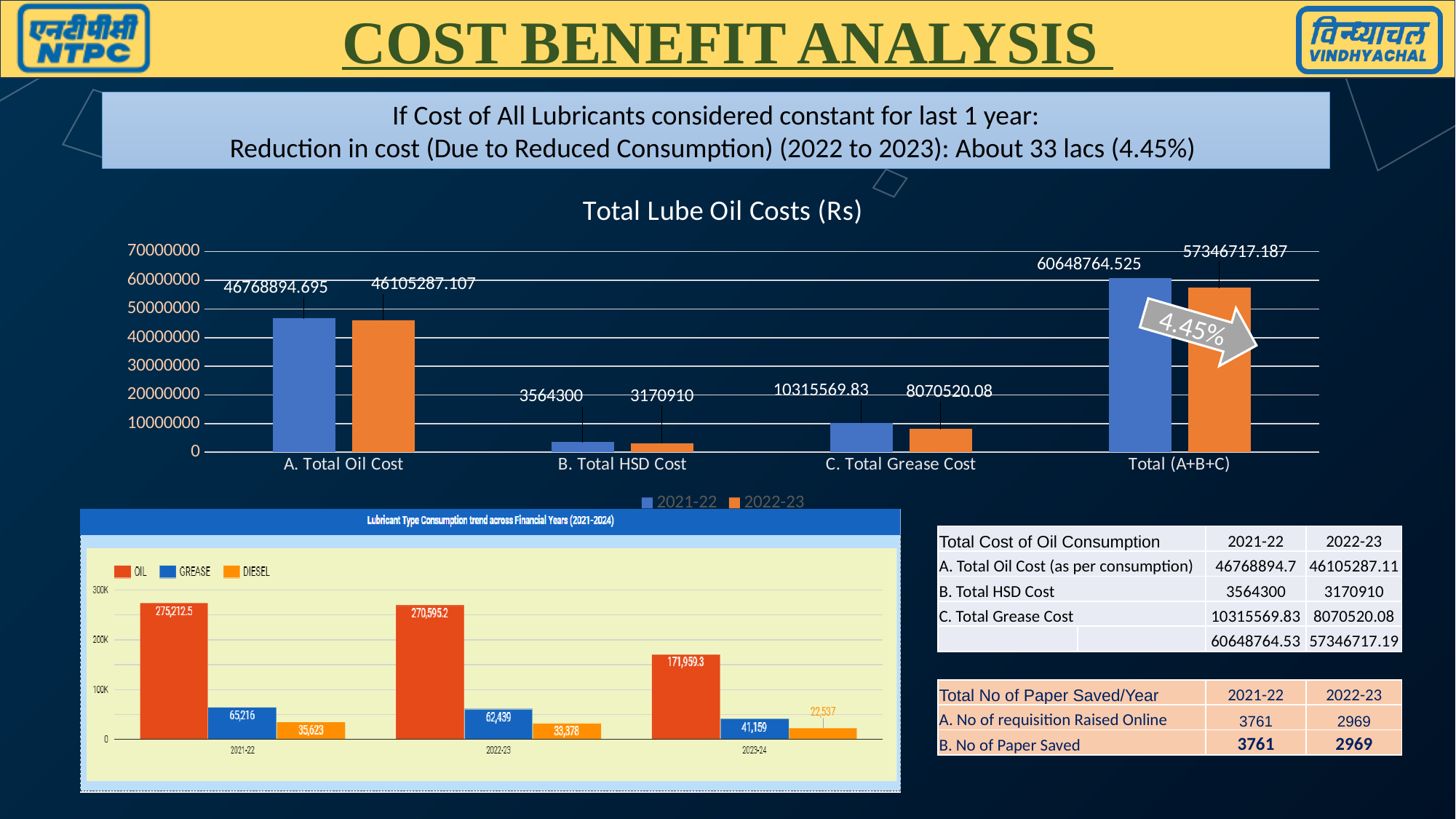
In the 'Lubricant Type Consumption trend across Financial Years (2021-2024)' chart, what is the OIL value for 2023-24? 171,959.3 In the 'Lubricant Type Consumption trend across Financial Years (2021-2024)' chart, how many financial years are shown on the x axis? 3 In the 'Total Lube Oil Costs (Rs)' chart, how many series does the legend list? 2 In the 'Total Lube Oil Costs (Rs)' chart, what is the Total (A+B+C) value for 2021-22? 60648764.525 In the 'Total Lube Oil Costs (Rs)' chart, is the 2022-23 value for A. Total Oil Cost greater or less than 50000000? less What kind of chart is the 'Lubricant Type Consumption trend across Financial Years (2021-2024)' chart? Bar chart In the 'Total Lube Oil Costs (Rs)' chart, what is the value for C. Total Grease Cost in 2022-23? 8070520.08 In the 'Total Lube Oil Costs (Rs)' chart, which category has the lowest values? B. Total HSD Cost In the 'Lubricant Type Consumption trend across Financial Years (2021-2024)' chart, how does the OIL value change from 2021-22 to 2023-24? It falls In the 'Total Lube Oil Costs (Rs)' chart, what is the value for B. Total HSD Cost in 2021-22? 3564300 In the 'Total Lube Oil Costs (Rs)' chart, what is the difference between the 2021-22 and 2022-23 values for B. Total HSD Cost? 393390 In the 'Lubricant Type Consumption trend across Financial Years (2021-2024)' chart, what is the GREASE value for 2022-23? 62,439